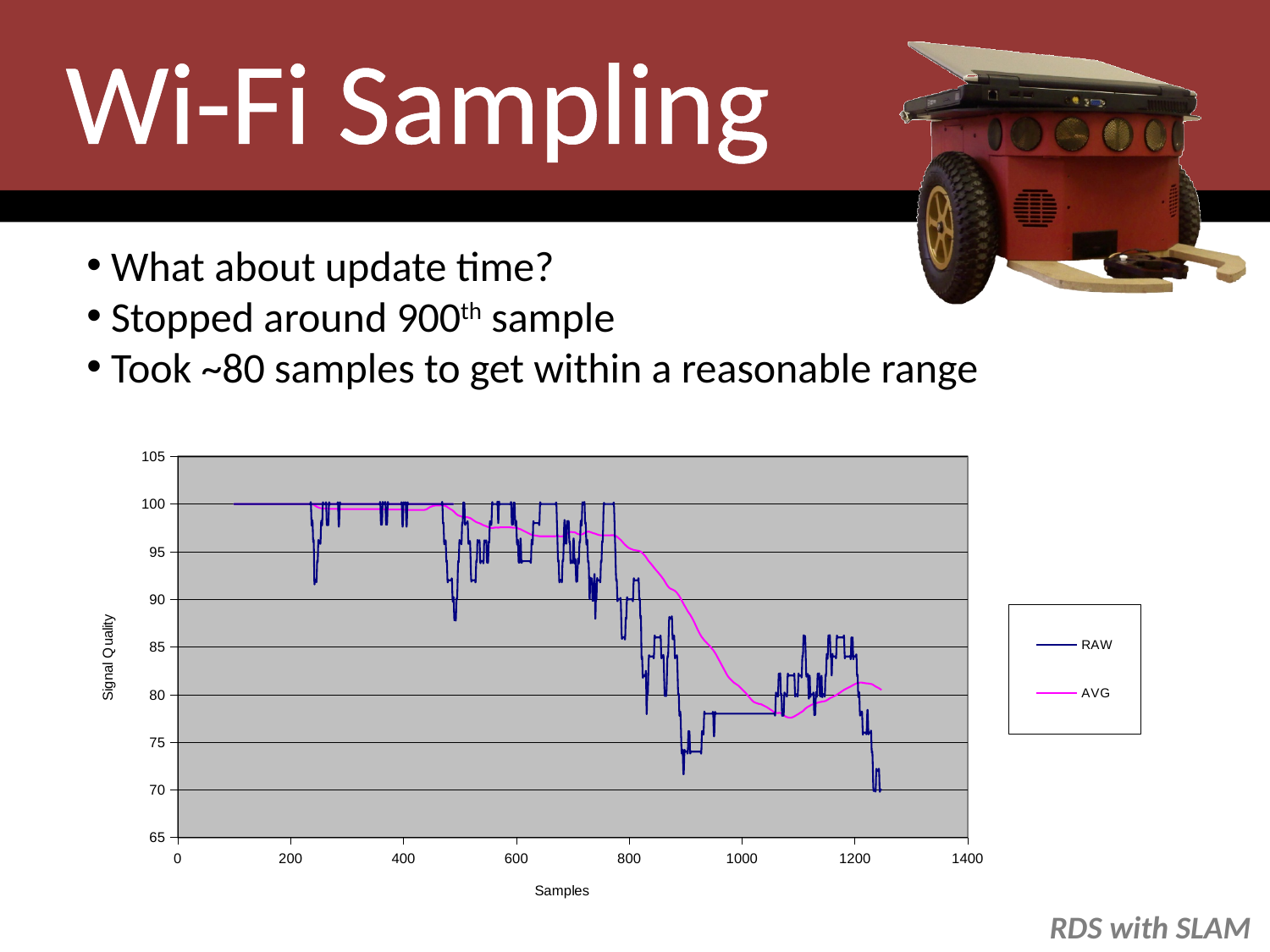
What is the highest value shown on the chart's vertical axis? 105 Overall, do the Signal Quality values rise or fall as the number of samples increases? fall How many series does the chart's legend list? 2 Is the AVG value at around sample 1100 greater or less than 85? less What kind of chart is shown on the slide? line chart What are the two series named in the chart's legend? RAW and AVG What is the title of the chart's vertical axis? Signal Quality Is the RAW value at around sample 900 greater or less than 80? less Is the lowest RAW value near the end of the series (around sample 1230) greater or less than 75? less Which series reaches the lowest Signal Quality value on the chart, RAW or AVG? RAW